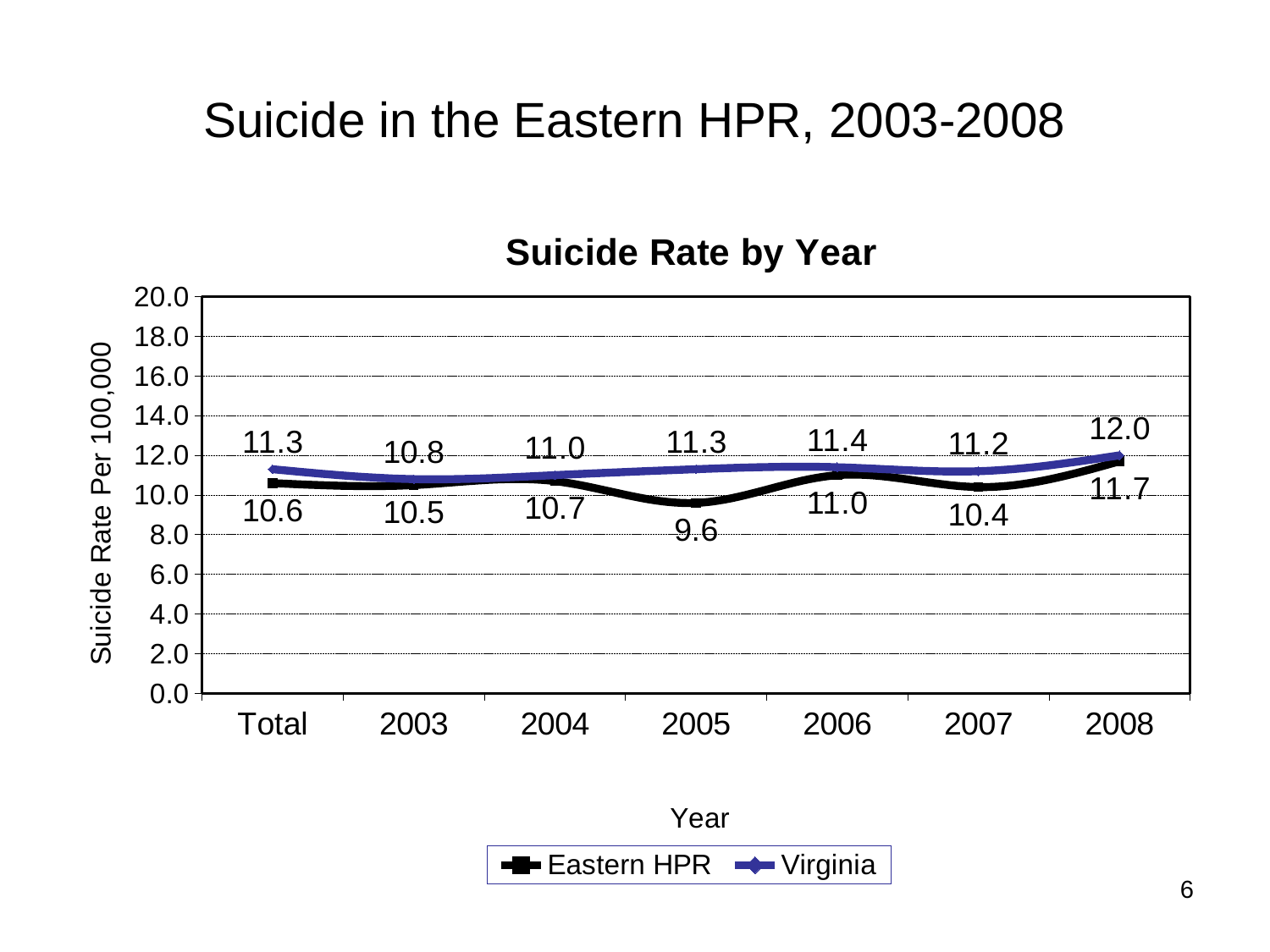
What is the suicide rate for Virginia in 2008? 12.0 How many categories are shown on the x axis? 7 What type of chart is shown on the slide? Line chart What is the suicide rate for Eastern HPR in 2005? 9.6 What is the Eastern HPR suicide rate for the Total category? 10.6 How many series does the legend list? 2 What is the title of the chart? Suicide Rate by Year Does the Eastern HPR suicide rate rise or fall from 2007 to 2008? Rise In which year is the Virginia suicide rate highest? 2008 Which series has the higher suicide rate in 2007, Eastern HPR or Virginia? Virginia What is the difference between the Virginia and Eastern HPR suicide rates in 2005? 1.7 In which year is the Eastern HPR suicide rate lowest? 2005